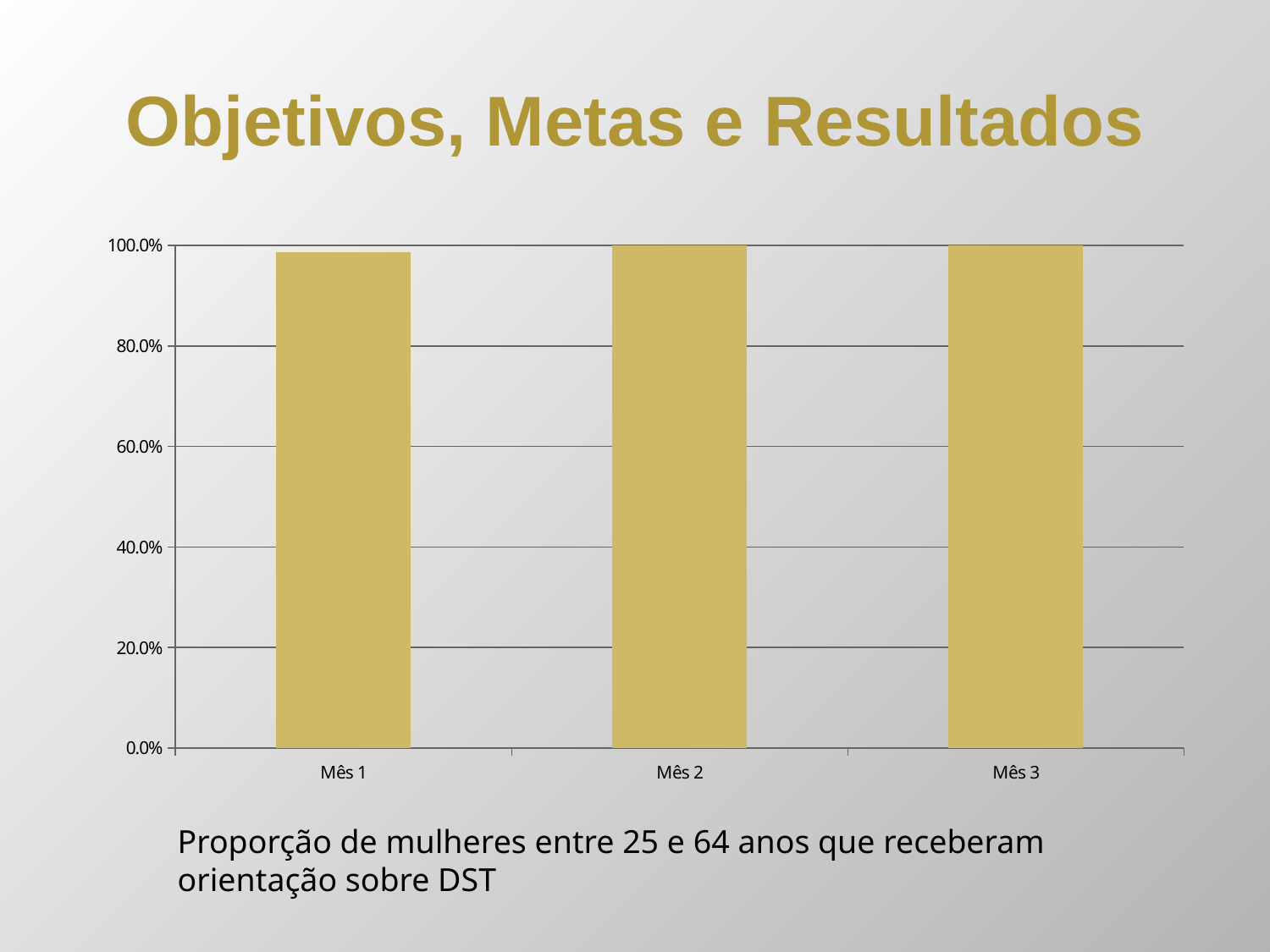
Is the value for Mês 1 greater or less than 80.0%? greater What does the text below the chart say the chart measures? Proporção de mulheres entre 25 e 64 anos que receberam orientação sobre DST Which month has the lowest value? Mês 1 Which is larger, the value for Mês 1 or the value for Mês 2? Mês 2 Is the value for Mês 1 greater or less than 60.0%? greater What is the highest value shown on the y axis? 100.0% What is the value for Mês 3? 100.0% What is the value for Mês 2? 100.0% What kind of chart is shown on the slide? bar chart How many categories are shown on the x axis of the chart? 3